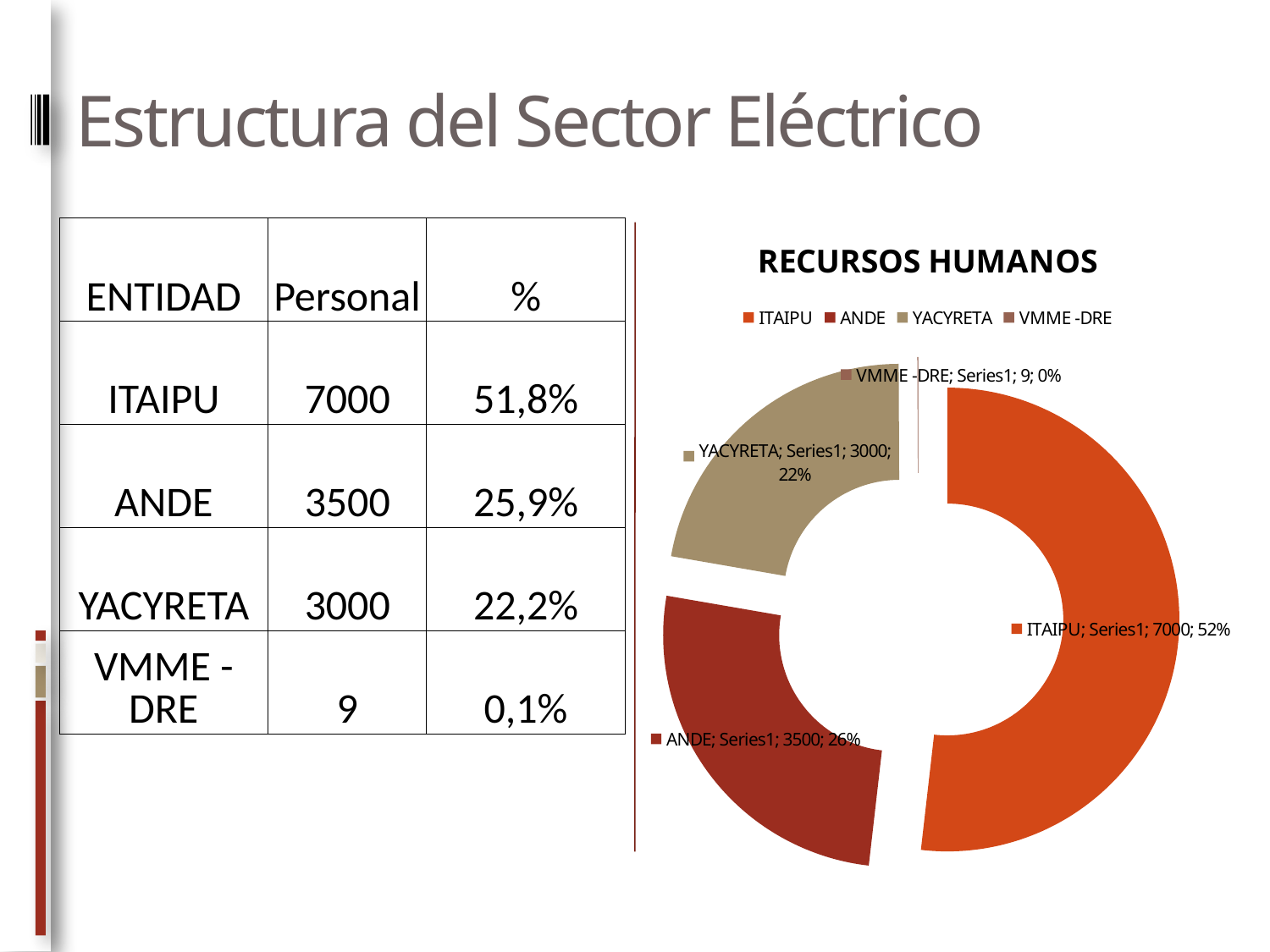
What is the value for YACYRETA in the chart? 3000 What is the title of the chart? RECURSOS HUMANOS Which category has the largest share of the chart? ITAIPU What is the value for ANDE in the chart? 3500 Which category has the smallest share of the chart? VMME -DRE What kind of chart is shown on the slide? Doughnut chart How many categories does the chart show? 4 What is the value for ITAIPU in the chart? 7000 Which is larger, the value for ANDE or the value for YACYRETA? ANDE What is the difference between the values for ITAIPU and ANDE? 3500 What percentage share does YACYRETA have in the chart? 22% What is the value for VMME -DRE in the chart? 9